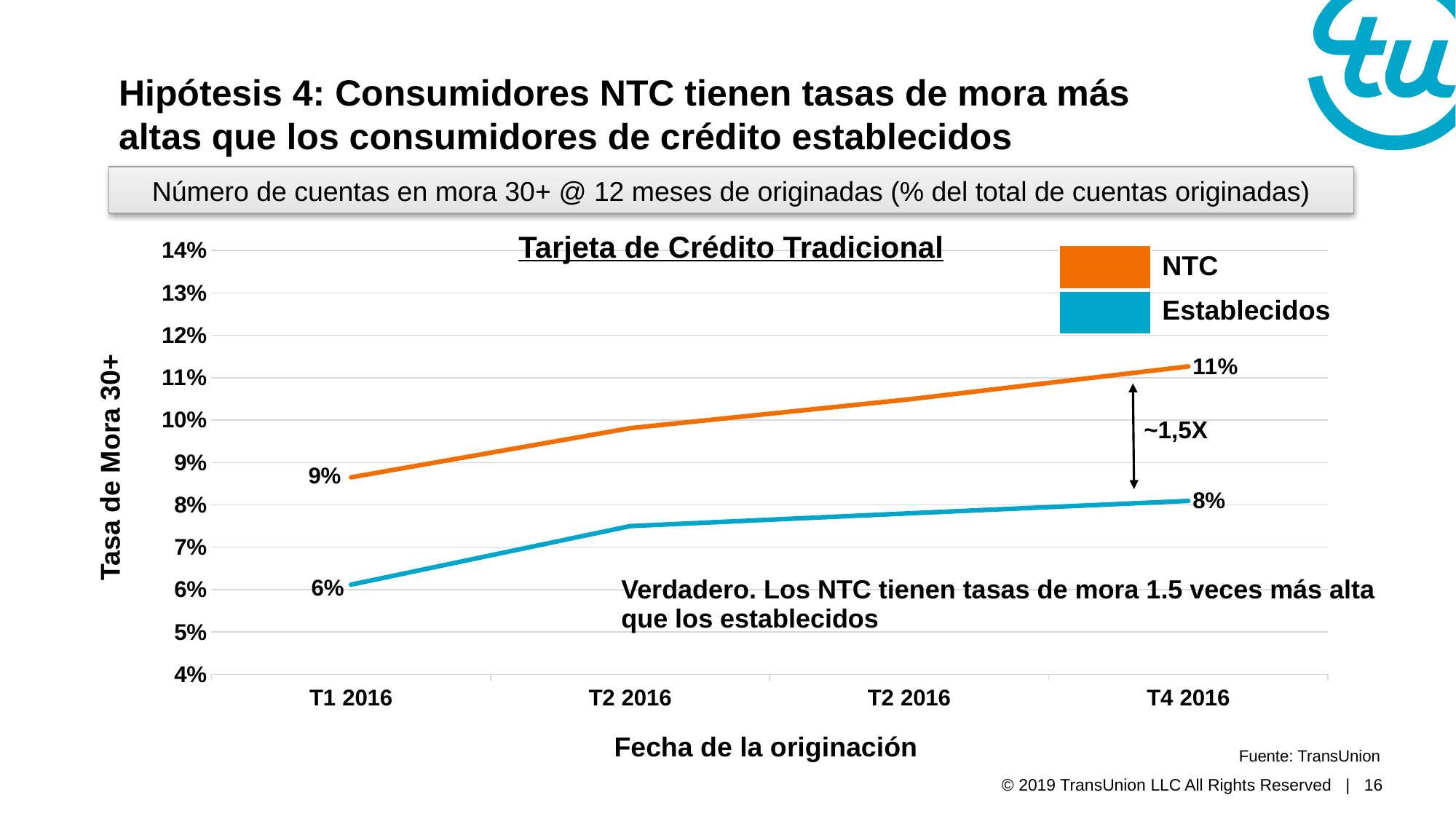
What is the difference between the NTC and Establecidos values at T4 2016? 3 percentage points How many series does the legend list? 2 Do the NTC values rise or fall from T1 2016 to T4 2016? Rise By how much did the NTC value change from T1 2016 to T4 2016? 2 percentage points What is the value for Establecidos at T1 2016? 6% What kind of chart is shown on the slide? Line chart Which series has the higher value at T4 2016, NTC or Establecidos? NTC What is the value for NTC at T1 2016? 9% How many points are shown along the x axis? 4 What is the value for NTC at T4 2016? 11% Is the value for Establecidos at the second x-axis point (T2 2016) greater or less than 8%? less What is the value for Establecidos at T4 2016? 8%